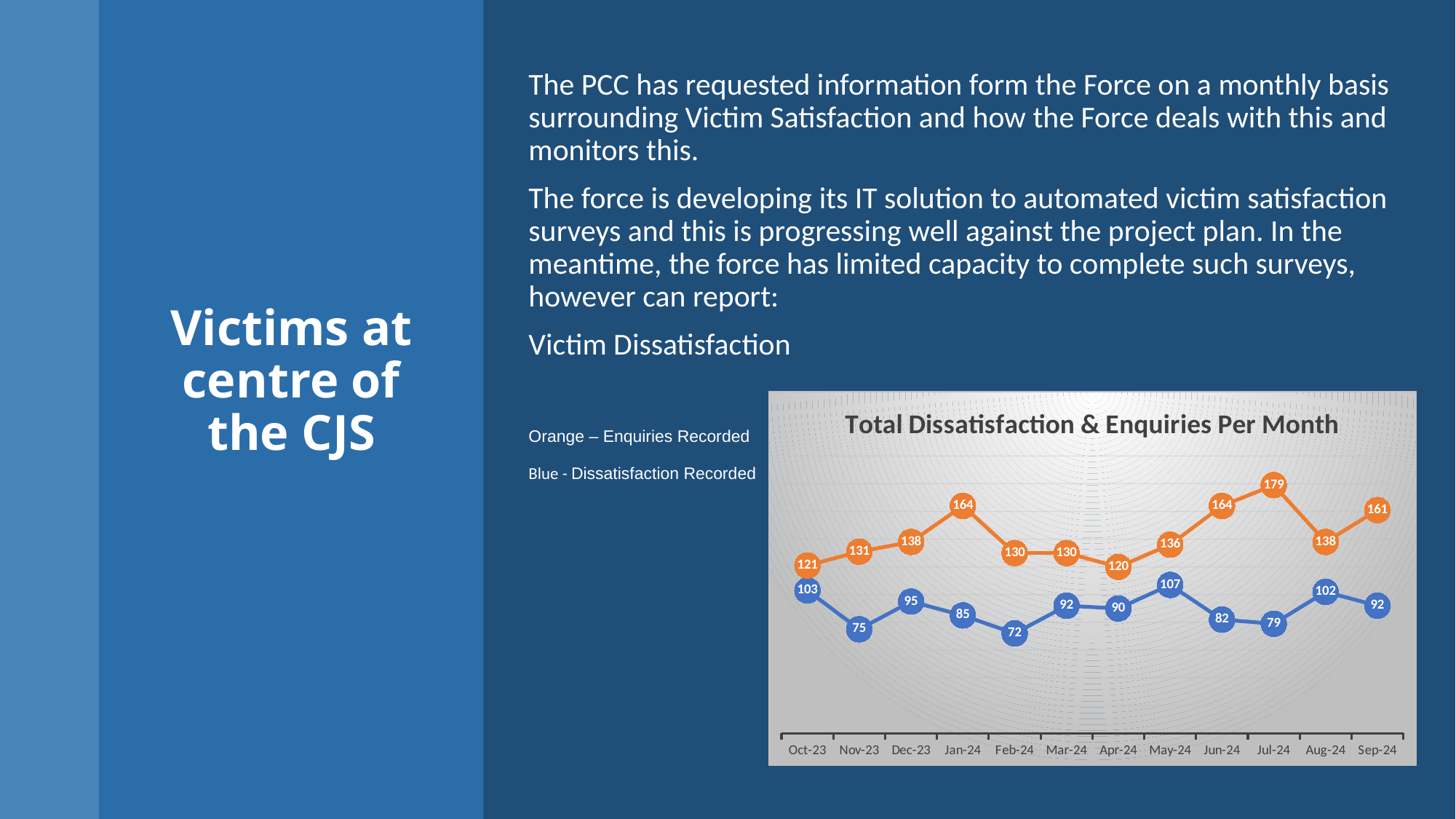
In which month is the Dissatisfaction Recorded (blue) value lowest? Feb-24 Does the Dissatisfaction Recorded (blue) value rise or fall from Oct-23 to Nov-23? Fall In which month is the Dissatisfaction Recorded (blue) value highest? May-24 Which is larger: the Enquiries Recorded value for Jan-24 or for Jun-24? They are equal (164) What is the difference between the Enquiries Recorded and Dissatisfaction Recorded values in Sep-24? 69 What is the Dissatisfaction Recorded (blue) value for Feb-24? 72 In which month is the Enquiries Recorded (orange) value highest? Jul-24 How many data series are plotted in the chart? 2 What type of chart is shown on the slide? Line chart What is the title of the chart? Total Dissatisfaction & Enquiries Per Month What is the Enquiries Recorded (orange) value for Jul-24? 179 How many months are plotted along the x axis of the chart? 12